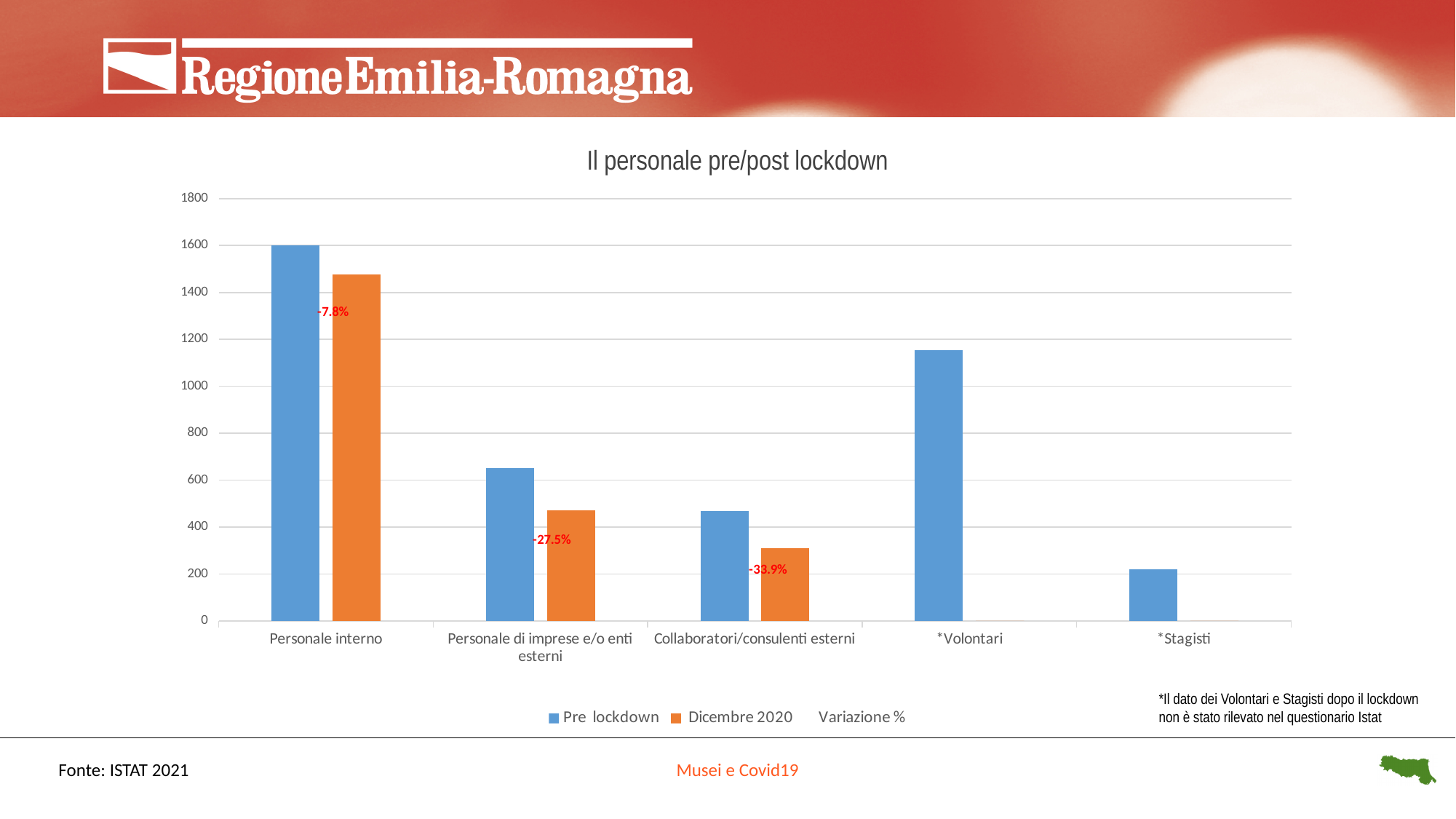
Is the Pre lockdown value for *Volontari greater or less than 1000? greater Which is larger: the Pre lockdown value for Personale di imprese e/o enti esterni or the Pre lockdown value for Collaboratori/consulenti esterni? Personale di imprese e/o enti esterni What is the Variazione % value shown for Personale di imprese e/o enti esterni? -27.5% What is the title of the chart? Il personale pre/post lockdown How many categories are shown on the x axis of the chart? 5 Which category has the lowest Pre lockdown value? *Stagisti Is the Dicembre 2020 value for Collaboratori/consulenti esterni greater or less than 400? less Which category has the highest Pre lockdown value? Personale interno What is the Variazione % value shown for Collaboratori/consulenti esterni? -33.9% How many series does the chart legend list? 3 What kind of chart is shown on the slide? bar chart What is the Variazione % value shown for Personale interno? -7.8%